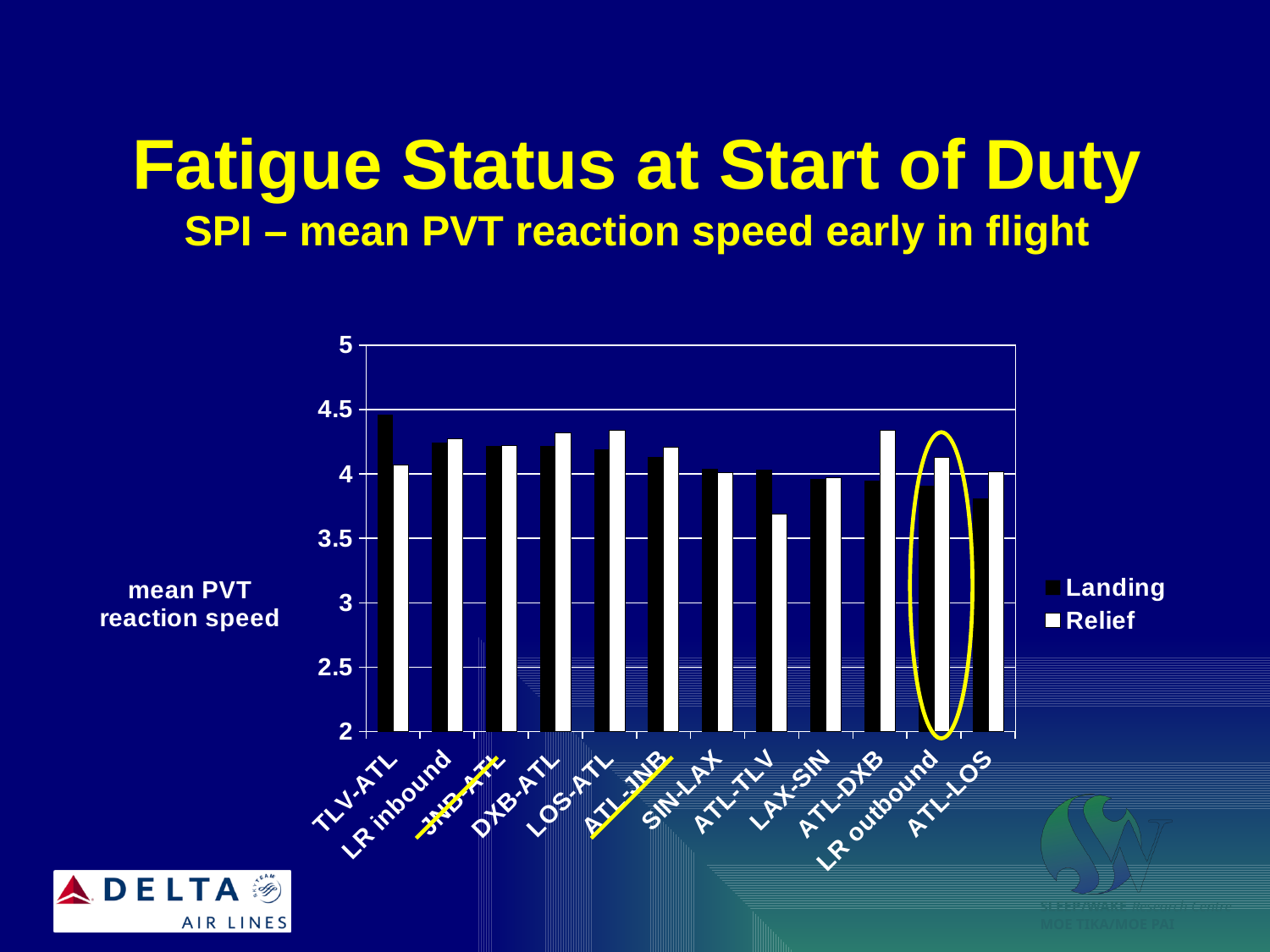
How many categories are shown along the x axis of the chart? 12 What are the two series named in the chart's legend? Landing and Relief Which category has the highest Landing value? TLV-ATL What kind of chart is shown on the slide? Bar chart How many series does the chart's legend list? 2 Is the Landing value for TLV-ATL greater or less than 4? greater For TLV-ATL, which is larger, the Landing value or the Relief value? Landing Is the Relief value for ATL-TLV greater or less than 4? less Do the Landing values generally rise or fall moving from left to right along the x axis? fall For ATL-DXB, which is larger, the Landing value or the Relief value? Relief Which category has the lowest Relief value? ATL-TLV Is the Landing value for ATL-LOS greater or less than 4? less